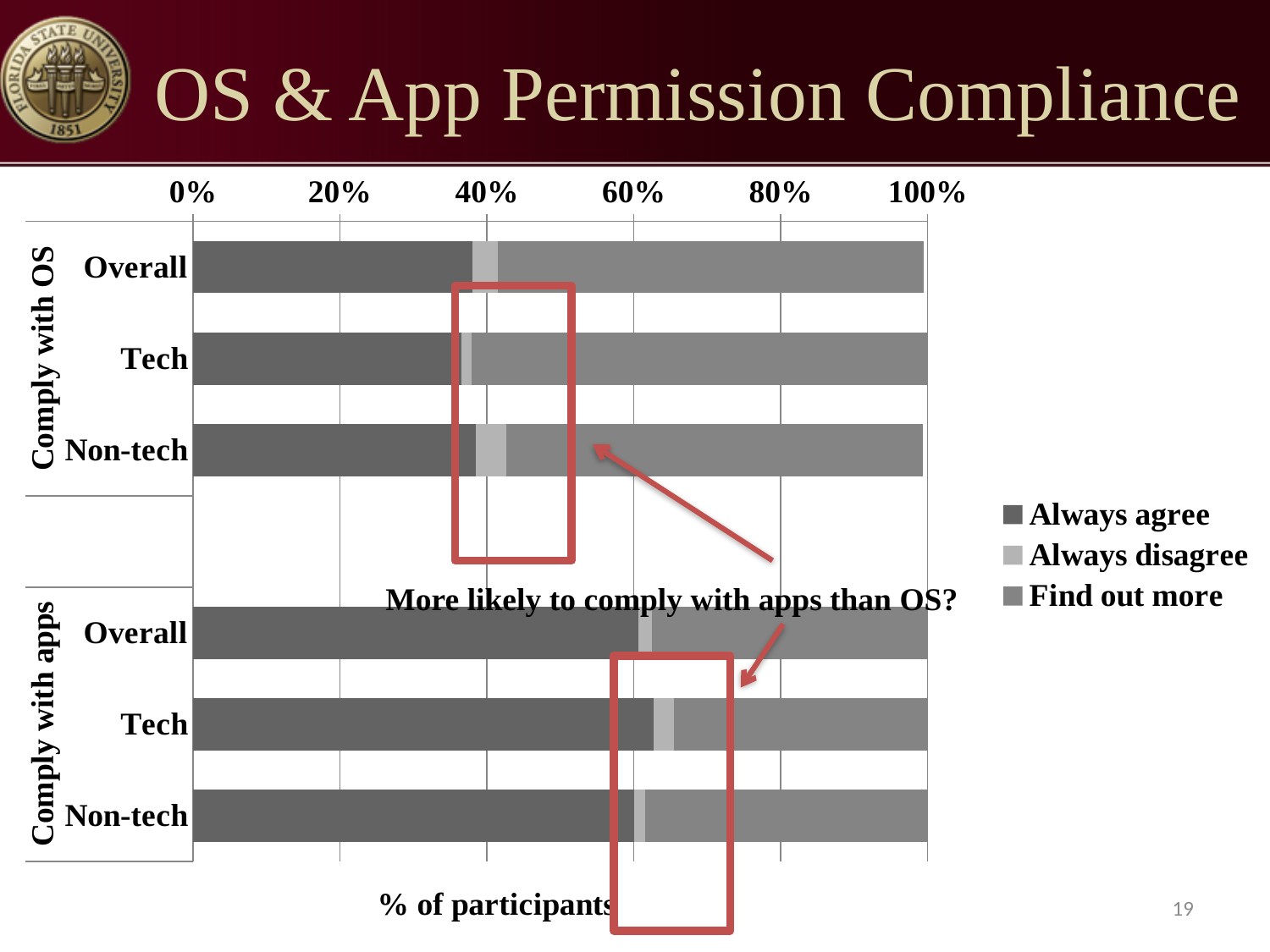
Is the 'Always agree' value for Overall under 'Comply with OS' greater or less than 40%? less Which has a larger 'Always agree' share: Overall under 'Comply with OS' or Overall under 'Comply with apps'? Overall under Comply with apps How many bars (categories) are plotted in the chart? 6 Which has a larger 'Find out more' share: Tech under 'Comply with OS' or Tech under 'Comply with apps'? Tech under Comply with OS What is the label on the horizontal axis of the chart? % of participants Is the 'Find out more' value for Overall under 'Comply with apps' greater or less than 60%? less What kind of chart is shown on the slide? stacked bar chart Is the 'Find out more' value for Overall under 'Comply with OS' greater or less than 40%? greater How many series does the legend list? 3